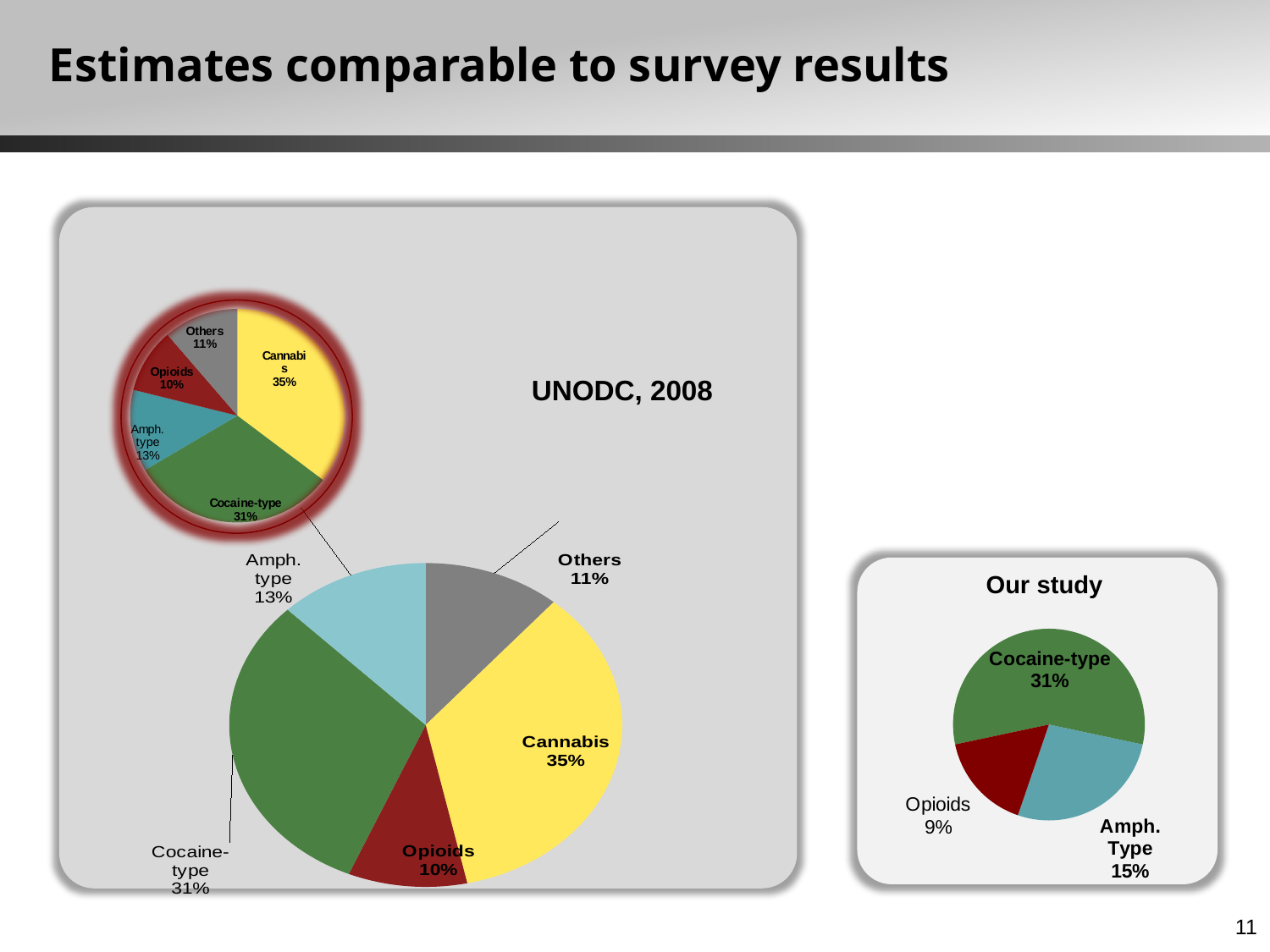
In the Our study pie chart, what share is Amph. Type? 15% In the Our study pie chart, which category has the largest share? Cocaine-type In the UNODC, 2008 pie chart, which category has the largest share? Cannabis In the UNODC, 2008 pie chart, what share is Opioids? 10% In the UNODC, 2008 pie chart, what is the difference between the Cannabis and Amph. type shares? 22 percentage points In the UNODC, 2008 pie chart, what share is Cocaine-type? 31% Which is larger: the Amph. type share in the UNODC, 2008 chart or the Amph. Type share in the Our study chart? Our study What type of chart is the Our study chart? Pie chart In the Our study pie chart, what share is Opioids? 9% In the UNODC, 2008 pie chart, how many categories are shown? 5 In the UNODC, 2008 pie chart, what share is Cannabis? 35% In the UNODC, 2008 pie chart, which category has the smallest share? Opioids